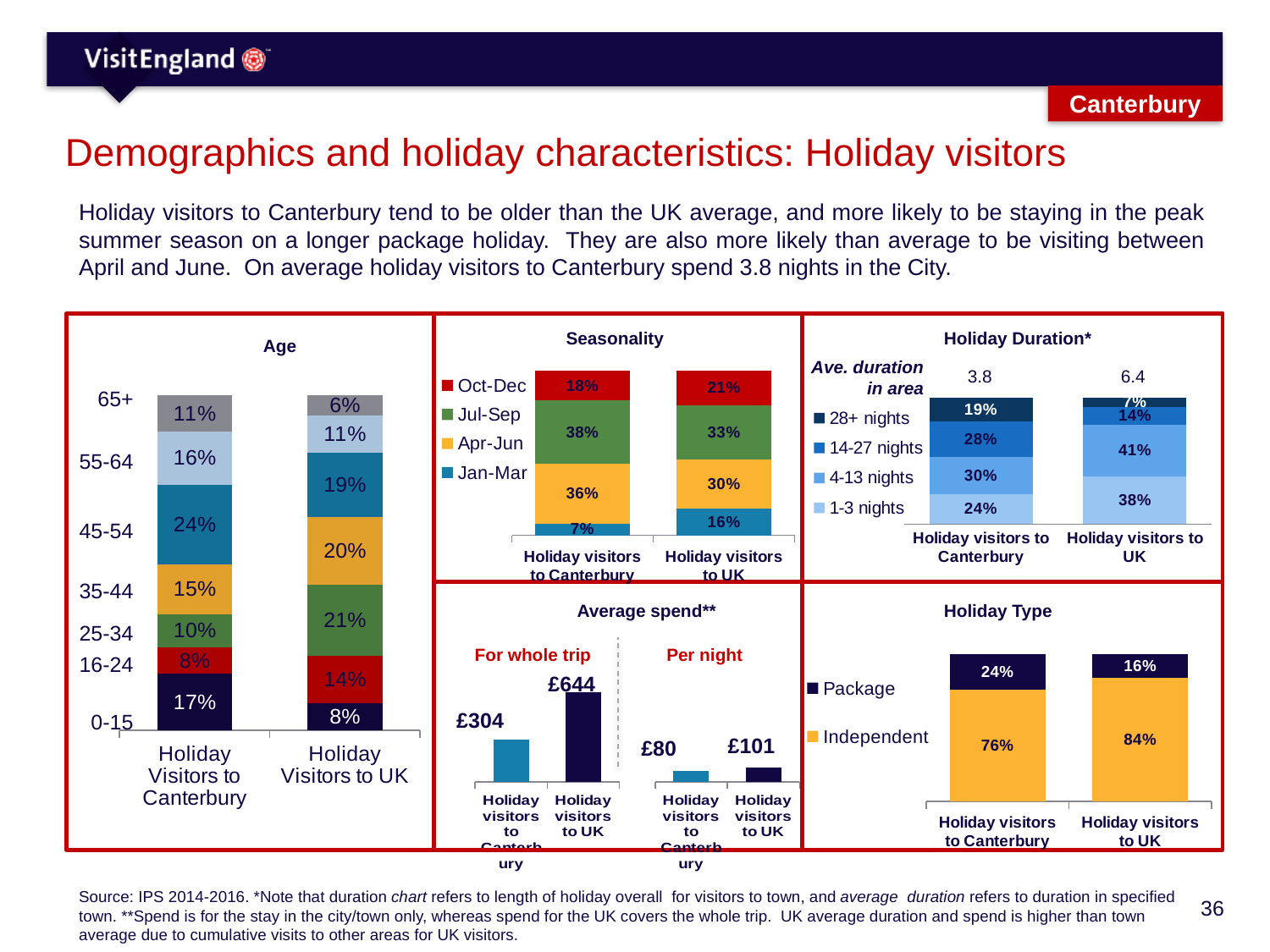
In the Age chart, which age group is the largest share of holiday visitors to the UK? 25-34 In the Age chart, what percentage of holiday visitors to the UK are aged 65+? 6% In the Holiday Duration chart, what share of holiday visitors to the UK stay 4-13 nights? 41% What type of chart is the Holiday Type chart? Stacked bar chart In the Holiday Duration chart, what is the average duration in area for holiday visitors to Canterbury? 3.8 In the Seasonality chart, what is the difference between the Apr-Jun share for holiday visitors to Canterbury and for holiday visitors to the UK? 6% In the Seasonality chart, what share of holiday visitors to Canterbury visit in Jan-Mar? 7% In the Seasonality chart, how many series does the legend list? 4 In the Average spend chart, what is the spend for the whole trip for holiday visitors to the UK? £644 In the Age chart, what percentage of holiday visitors to Canterbury are aged 45-54? 24% In the Holiday Type chart, which group has the larger Package share: holiday visitors to Canterbury or holiday visitors to the UK? Holiday visitors to Canterbury In the Average spend chart, what is the difference in per night spend between holiday visitors to the UK and holiday visitors to Canterbury? £21